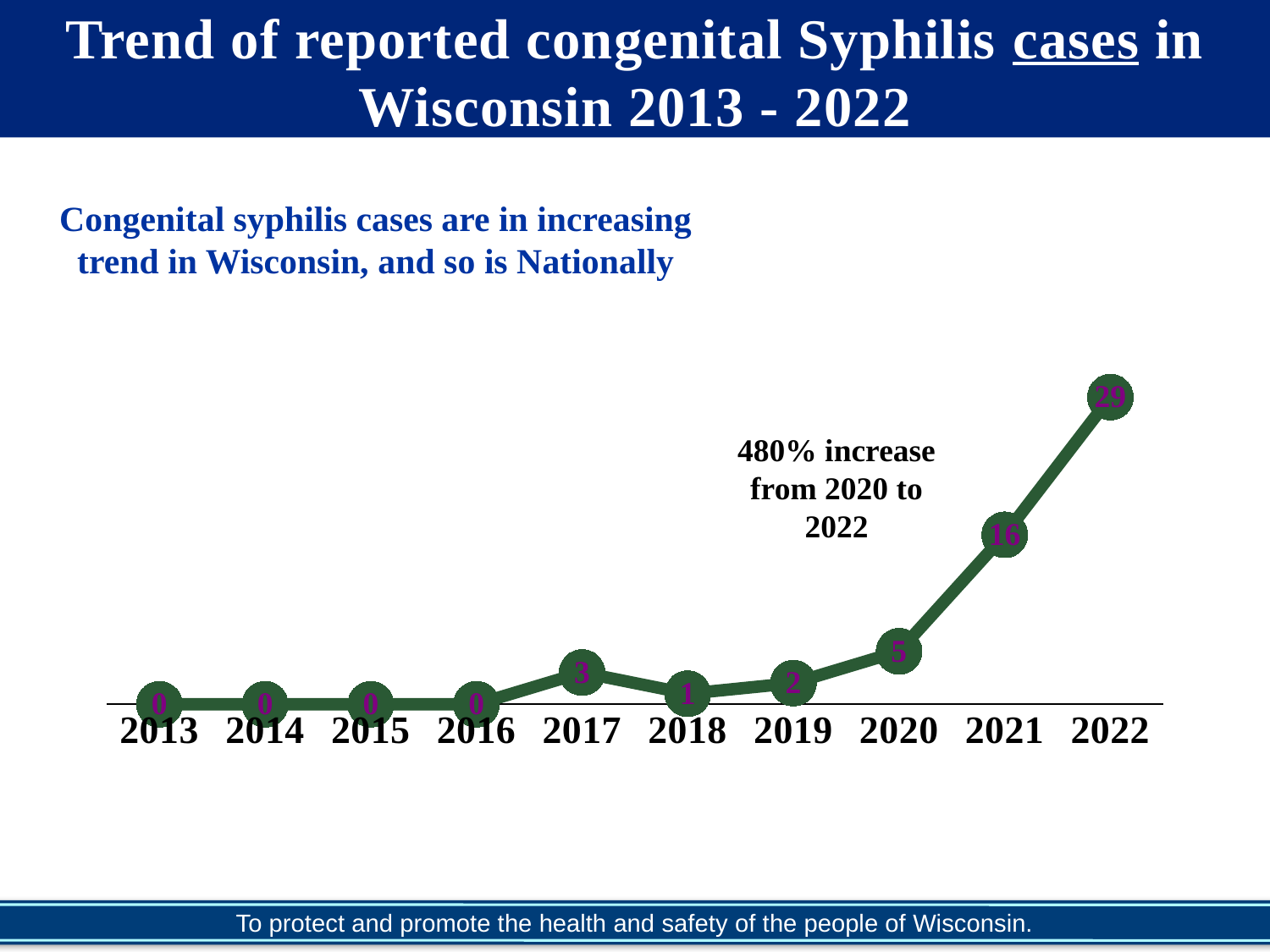
How many reported congenital syphilis cases were there in 2017? 3 How many reported congenital syphilis cases were there in 2020? 5 What is the difference in reported cases between 2022 and 2021? 13 How many reported congenital syphilis cases were there in 2021? 16 Which year has the highest number of reported congenital syphilis cases? 2022 Do the reported congenital syphilis cases generally rise or fall from 2013 to 2022? rise What type of chart is shown on the slide? line chart What is the difference in reported cases between 2021 and 2020? 11 How many years are plotted on the x axis of the chart? 10 Which year had more reported cases, 2017 or 2018? 2017 How many reported congenital syphilis cases were there in Wisconsin in 2022? 29 What percentage increase from 2020 to 2022 is annotated on the chart? 480%